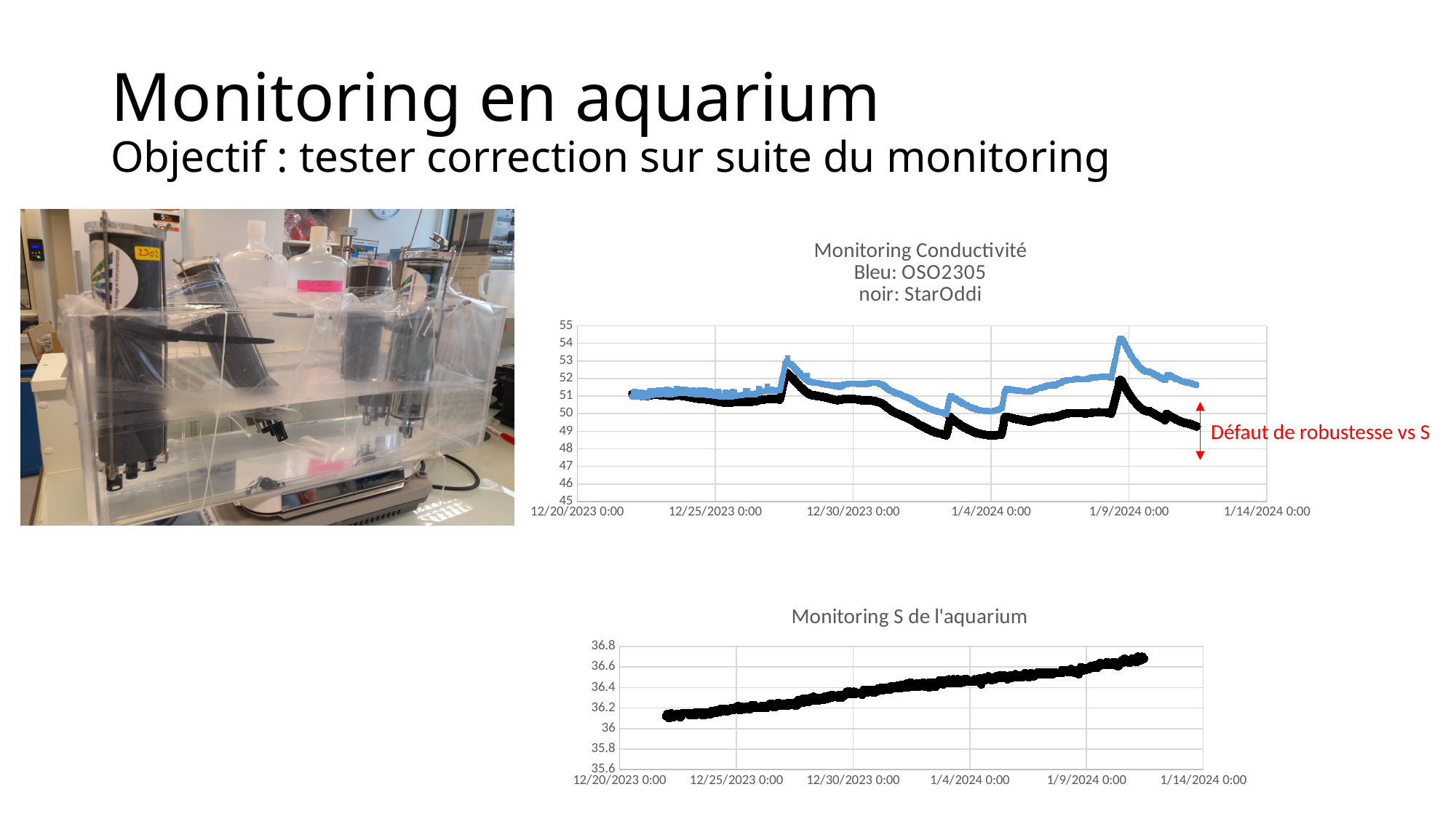
In the 'Monitoring S de l'aquarium' chart, is the value at the start of the period greater or less than 36.2? less How many series are plotted in the 'Monitoring Conductivité' chart? 2 What kind of chart is the 'Monitoring S de l'aquarium' chart? line chart In the 'Monitoring Conductivité' chart, is the lowest value of the black StarOddi series greater or less than 49? less In the 'Monitoring Conductivité' chart, is the black StarOddi value at the end of the period greater or less than 50? less In the 'Monitoring Conductivité' chart, which series is higher at the end of the period, the blue OSO2305 or the black StarOddi? blue OSO2305 According to the title of the 'Monitoring Conductivité' chart, which sensor is plotted in blue? OSO2305 What kind of chart is the 'Monitoring Conductivité' chart? line chart According to the title of the 'Monitoring Conductivité' chart, which sensor is plotted in black? StarOddi In the 'Monitoring S de l'aquarium' chart, do the values rise or fall along the x axis? rise